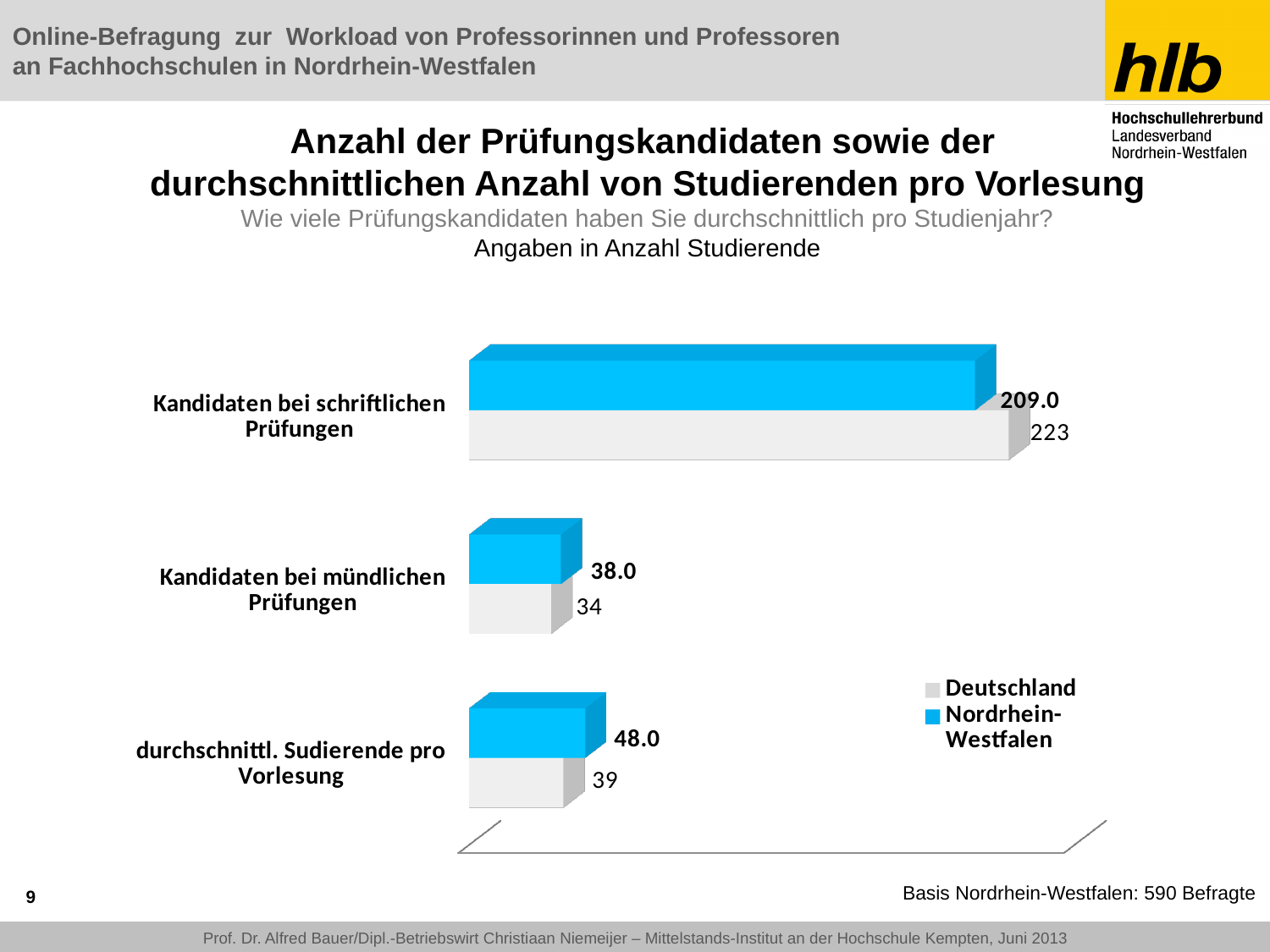
What is the difference between the Nordrhein-Westfalen and Deutschland values for "durchschnittl. Sudierende pro Vorlesung"? 9 What is the value for Nordrhein-Westfalen for "Kandidaten bei schriftlichen Prüfungen"? 209.0 How many categories are shown in the chart? 3 For "Kandidaten bei mündlichen Prüfungen", which is larger: the Deutschland value or the Nordrhein-Westfalen value? Nordrhein-Westfalen Which category has the highest value for Nordrhein-Westfalen? Kandidaten bei schriftlichen Prüfungen What is the difference between the Deutschland and Nordrhein-Westfalen values for "Kandidaten bei schriftlichen Prüfungen"? 14 What is the value for Deutschland for "durchschnittl. Sudierende pro Vorlesung"? 39 What kind of chart is shown on the slide? Bar chart How many series does the legend list? 2 Which category has the lowest value for Deutschland? Kandidaten bei mündlichen Prüfungen What is the value for Nordrhein-Westfalen for "Kandidaten bei mündlichen Prüfungen"? 38.0 What is the value for Deutschland for "Kandidaten bei schriftlichen Prüfungen"? 223